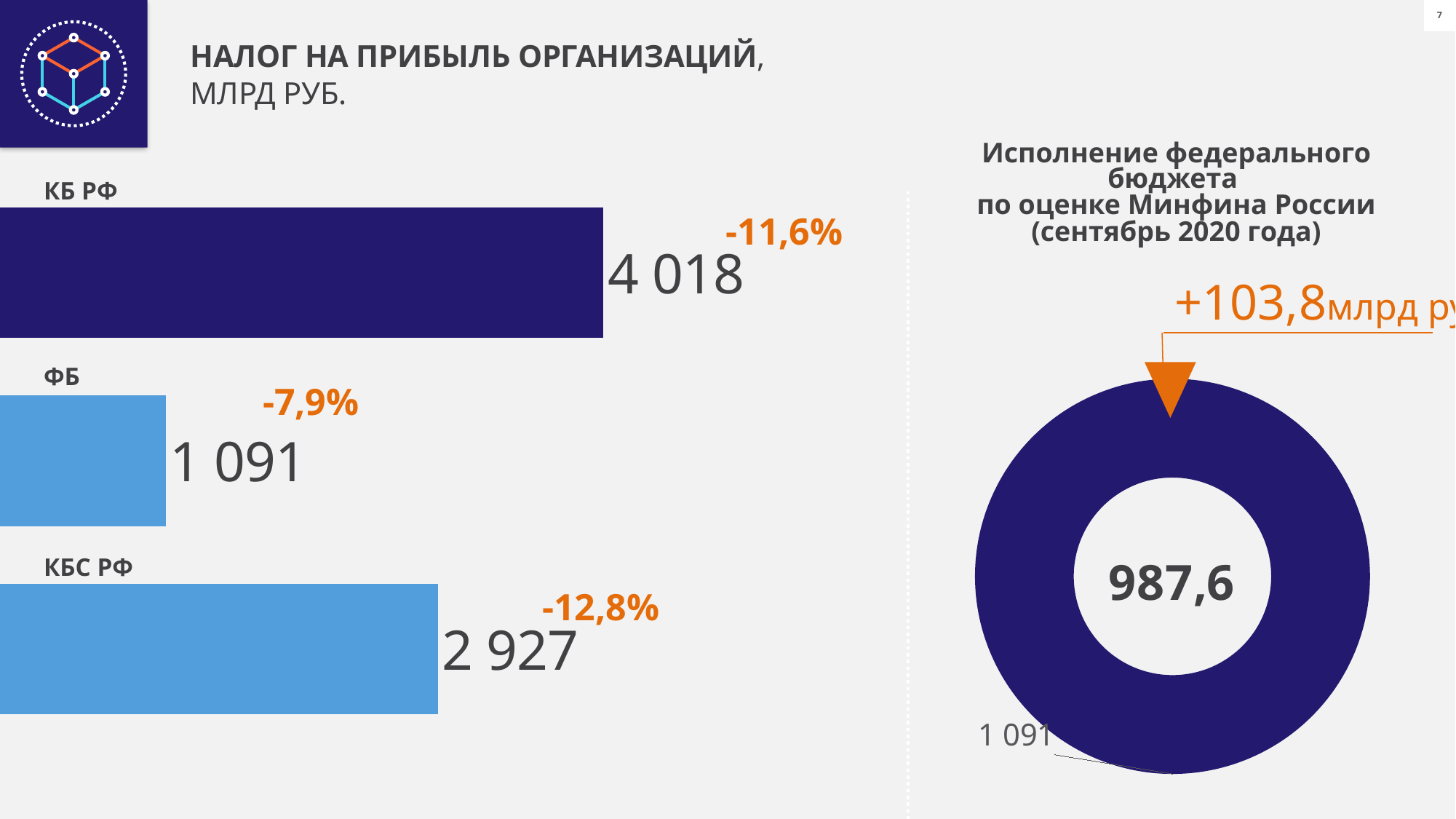
How many categories does the bar chart on the left show? 3 In the bar chart on the left, which category has the highest value? КБ РФ In the bar chart on the left, which is larger, the value for КБС РФ or the value for ФБ? КБС РФ What kind of chart is shown on the left of the slide? Bar chart In the bar chart on the left, what is the value for КБС РФ? 2 927 In the bar chart on the left, what percentage change is shown next to the КБС РФ bar? -12,8% In the bar chart on the left, which category has the lowest value? ФБ In the bar chart on the left, what is the value for ФБ? 1 091 In the bar chart on the left, what percentage change is shown next to the ФБ bar? -7,9% In the bar chart on the left, what is the difference between the values for КБ РФ and КБС РФ? 1 091 In the bar chart on the left, what is the value for КБ РФ? 4 018 What value is printed in the centre of the donut chart on the right? 987,6